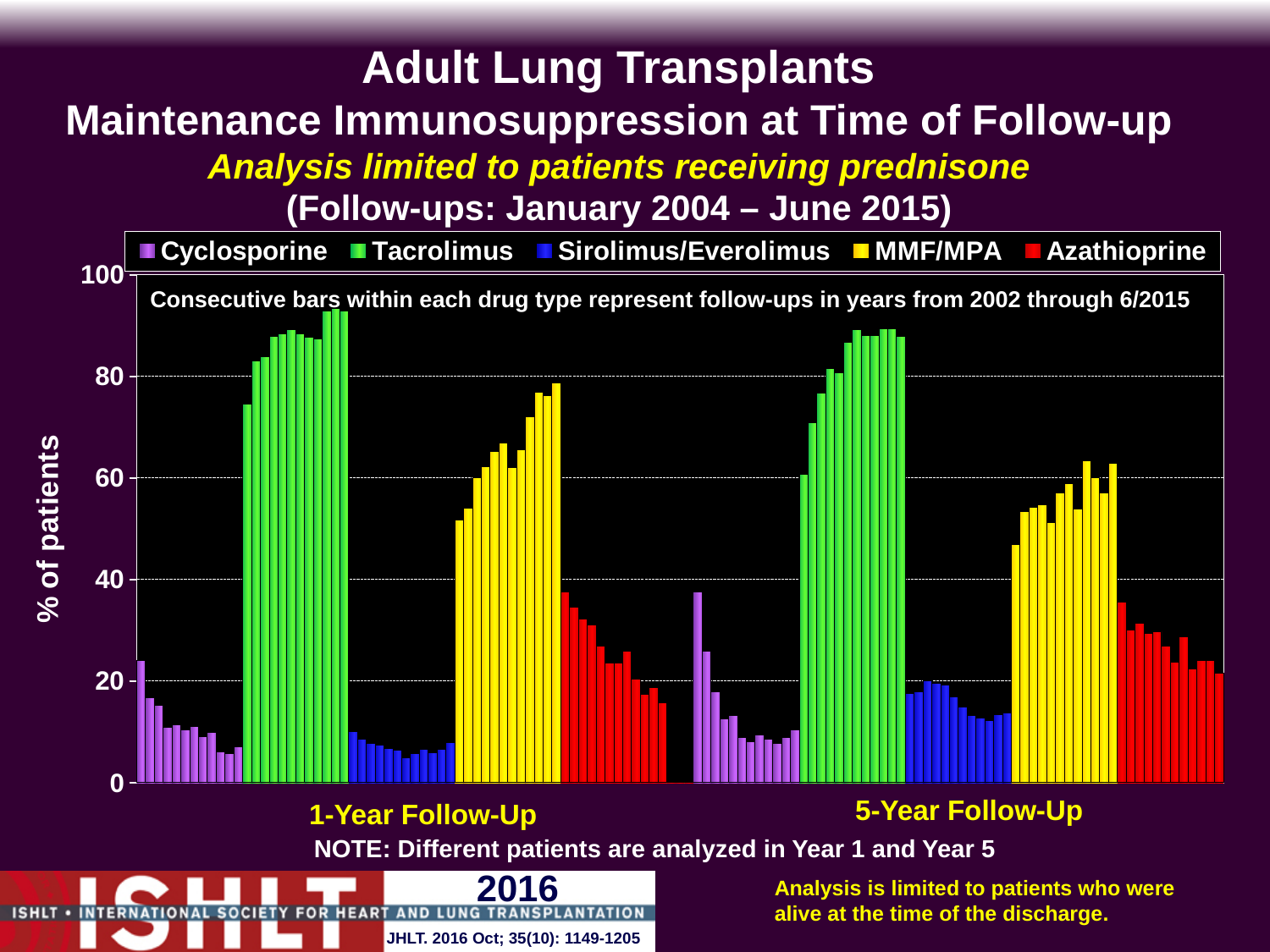
Do the Azathioprine bars in the 1-Year Follow-Up group rise or fall from left to right? Fall Which drug types are listed in the legend? Cyclosporine, Tacrolimus, Sirolimus/Everolimus, MMF/MPA, Azathioprine In the 1-Year Follow-Up group, which drug type has the lowest bars? Sirolimus/Everolimus In the 1-Year Follow-Up group, which drug type has the tallest bars? Tacrolimus What is the label of the vertical axis? % of patients Do the Cyclosporine bars in the 5-Year Follow-Up group rise or fall from left to right? Fall Is the tallest Tacrolimus bar in the 1-Year Follow-Up group greater or less than 80? greater How many follow-up groups are shown along the x axis? 2 How many series does the legend list? 5 What kind of chart is shown on the slide? Bar chart Do the Tacrolimus bars in the 1-Year Follow-Up group rise or fall from left to right? Rise In the 5-Year Follow-Up group, are the MMF/MPA bars or the Azathioprine bars higher? MMF/MPA